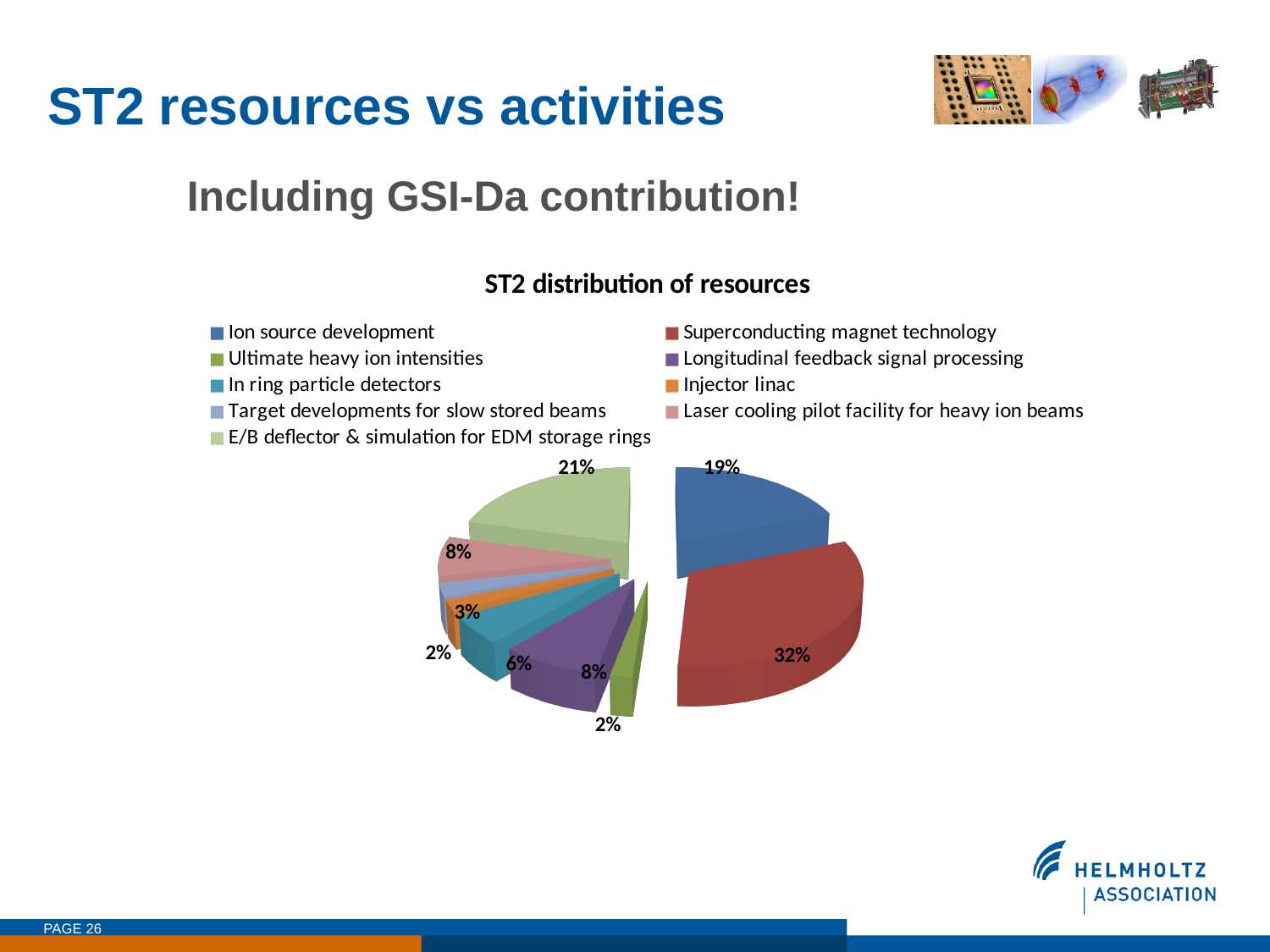
What is the difference in percentage points between the shares for Superconducting magnet technology and Ion source development? 13 What share of ST2 resources goes to E/B deflector & simulation for EDM storage rings? 21% How many categories does the legend of the pie chart list? 9 Which receives a larger share of ST2 resources, Ion source development or E/B deflector & simulation for EDM storage rings? E/B deflector & simulation for EDM storage rings What kind of chart is shown on the slide? pie chart What share of ST2 resources goes to Ion source development? 19% What is the title of the chart? ST2 distribution of resources What share of ST2 resources goes to Superconducting magnet technology? 32% Which category receives the largest share of ST2 resources? Superconducting magnet technology